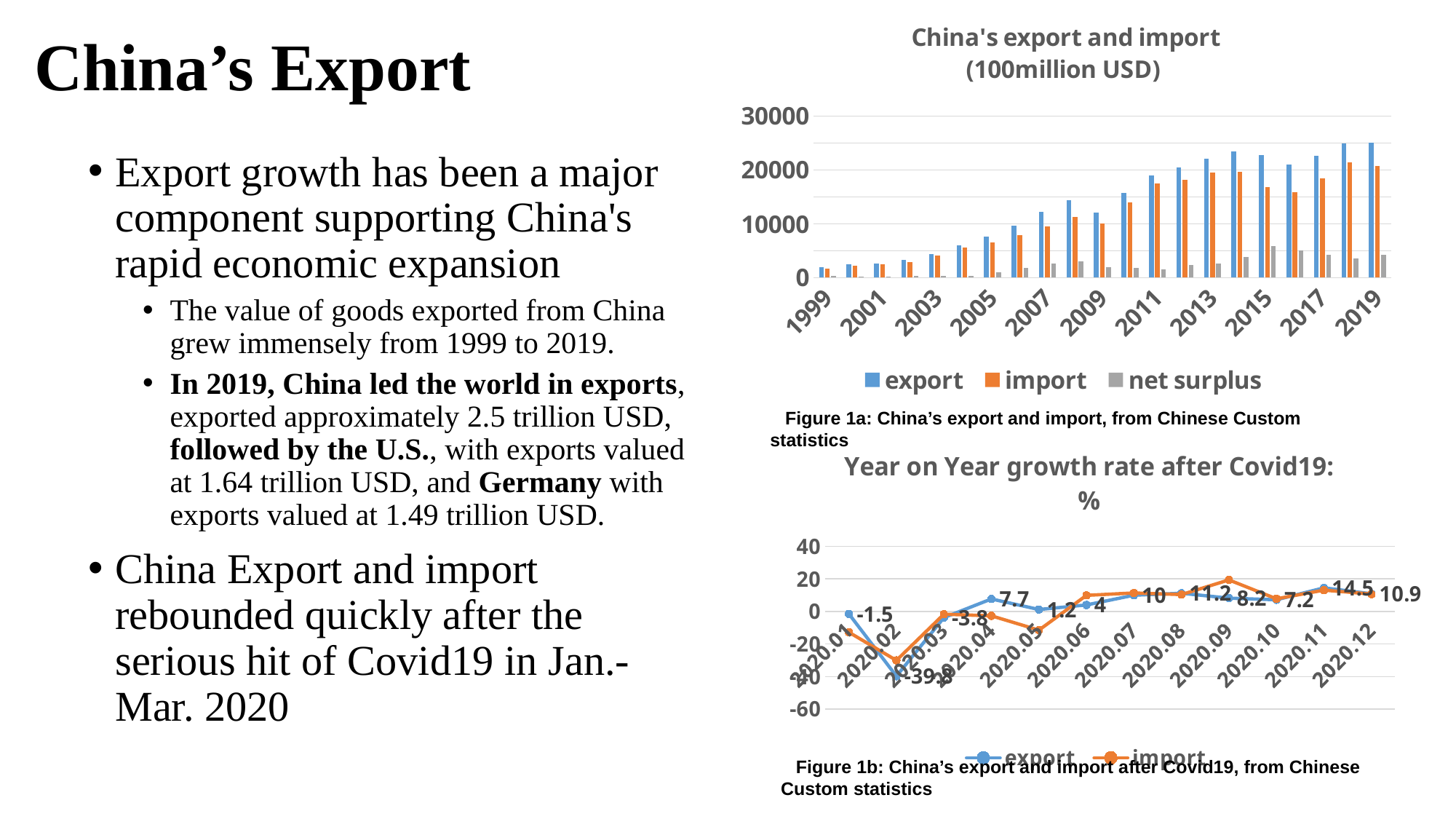
In the 'Year on Year growth rate after Covid19: %' chart, which month has the lowest export growth rate? 2020.02 How many series does the legend of the 'China's export and import (100million USD)' chart list? 3 What kind of chart is the 'Year on Year growth rate after Covid19: %' chart? line chart What kind of chart is the 'China's export and import (100million USD)' chart? bar chart How many series does the legend of the 'Year on Year growth rate after Covid19: %' chart list? 2 In the 'Year on Year growth rate after Covid19: %' chart, what is the export growth rate for 2020.12? 10.9 In the 'China's export and import (100million USD)' chart, is the export value for 2005 greater or less than 10000? less In the 'China's export and import (100million USD)' chart, is the export value for 2019 greater or less than 20000? greater In the 'China's export and import (100million USD)' chart, is the net surplus value for 2019 greater or less than 10000? less In the 'Year on Year growth rate after Covid19: %' chart, what is the difference between the export growth rates for 2020.11 and 2020.12? 3.6 In the 'Year on Year growth rate after Covid19: %' chart, what is the export growth rate for 2020.11? 14.5 In the 'China's export and import (100million USD)' chart, do export values generally rise or fall from 1999 to 2019? rise